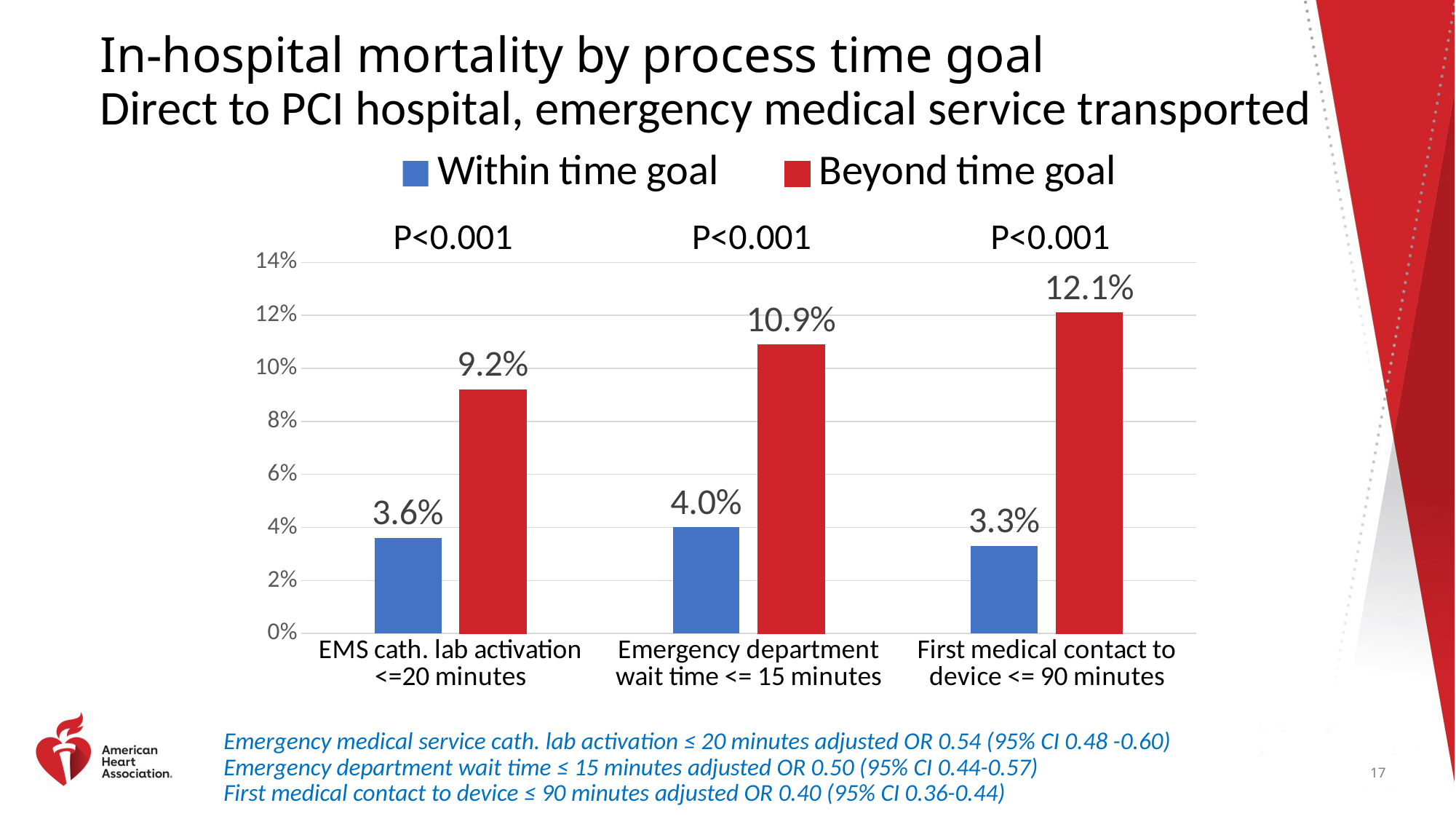
Which category has the lowest 'Within time goal' value? First medical contact to device <= 90 minutes Which is larger: the 'Within time goal' value for 'Emergency department wait time <= 15 minutes' or the 'Within time goal' value for 'EMS cath. lab activation <=20 minutes'? Emergency department wait time <= 15 minutes How many series does the legend list? 2 What is the value for 'Beyond time goal' in the 'Emergency department wait time <= 15 minutes' category? 10.9% What colour represents the 'Beyond time goal' series? Red How many categories are shown on the x axis? 3 What is the difference between the 'Beyond time goal' and 'Within time goal' values for 'EMS cath. lab activation <=20 minutes'? 5.6% Which category has the highest 'Beyond time goal' value? First medical contact to device <= 90 minutes What is the difference between the 'Beyond time goal' and 'Within time goal' values for 'First medical contact to device <= 90 minutes'? 8.8% What kind of chart is shown on the slide? Bar chart What is the in-hospital mortality for 'Within time goal' in the 'EMS cath. lab activation <=20 minutes' category? 3.6% What is the in-hospital mortality for 'Beyond time goal' in the 'First medical contact to device <= 90 minutes' category? 12.1%